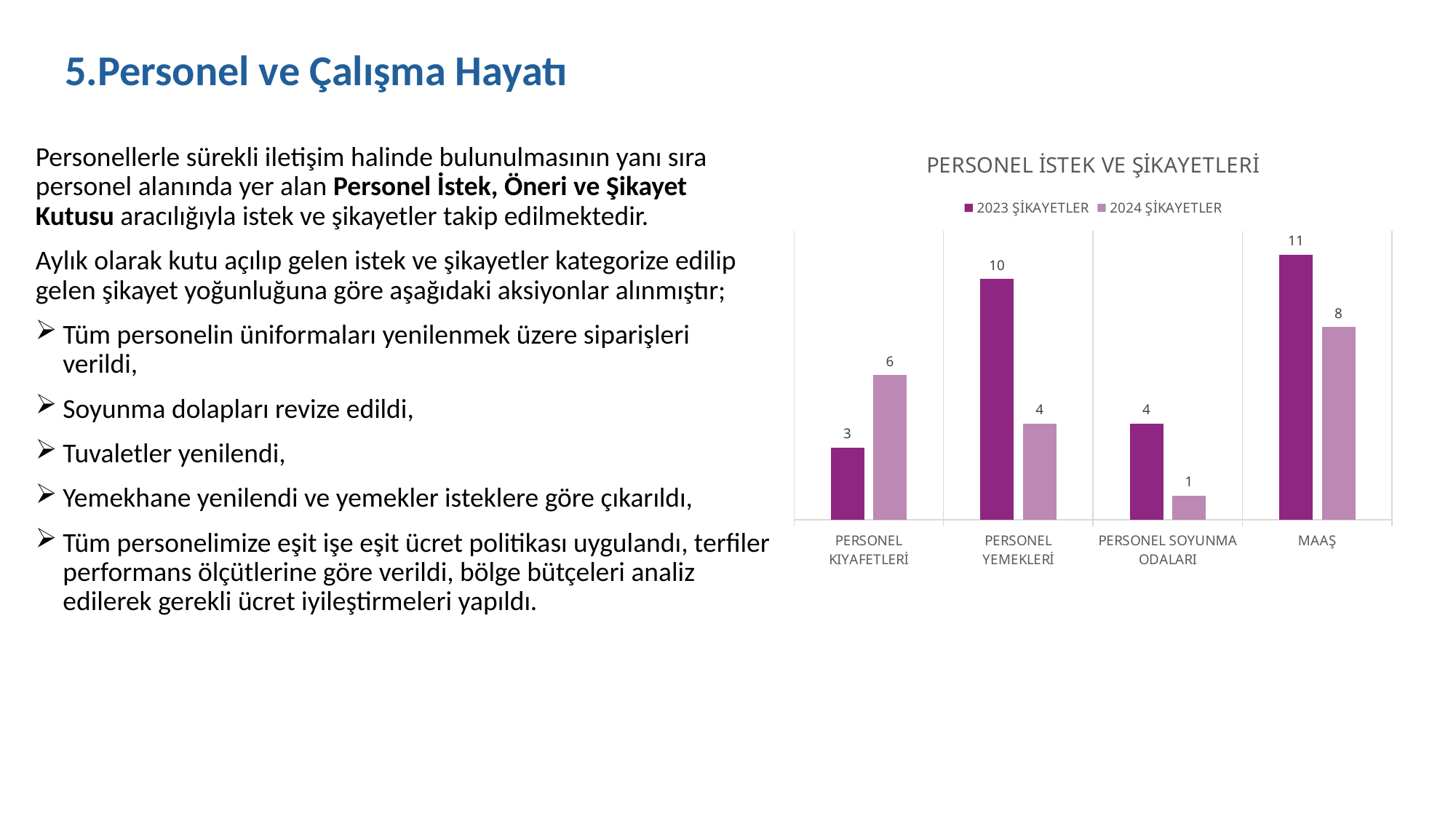
Which category has the lowest 2024 ŞİKAYETLER value? PERSONEL SOYUNMA ODALARI What is the title of the chart? PERSONEL İSTEK VE ŞİKAYETLERİ How many series does the legend list? 2 Which is larger for PERSONEL KIYAFETLERİ: the 2023 ŞİKAYETLER value or the 2024 ŞİKAYETLER value? 2024 ŞİKAYETLER How many categories are shown on the x axis of the chart? 4 Which category has the highest 2023 ŞİKAYETLER value? MAAŞ What is the 2024 ŞİKAYETLER value for MAAŞ? 8 What is the difference between the 2023 and 2024 ŞİKAYETLER values for PERSONEL YEMEKLERİ? 6 What is the difference between the 2023 ŞİKAYETLER values for MAAŞ and PERSONEL KIYAFETLERİ? 8 What is the 2023 ŞİKAYETLER value for PERSONEL YEMEKLERİ? 10 What kind of chart is shown on the slide? Bar chart What is the 2024 ŞİKAYETLER value for PERSONEL KIYAFETLERİ? 6